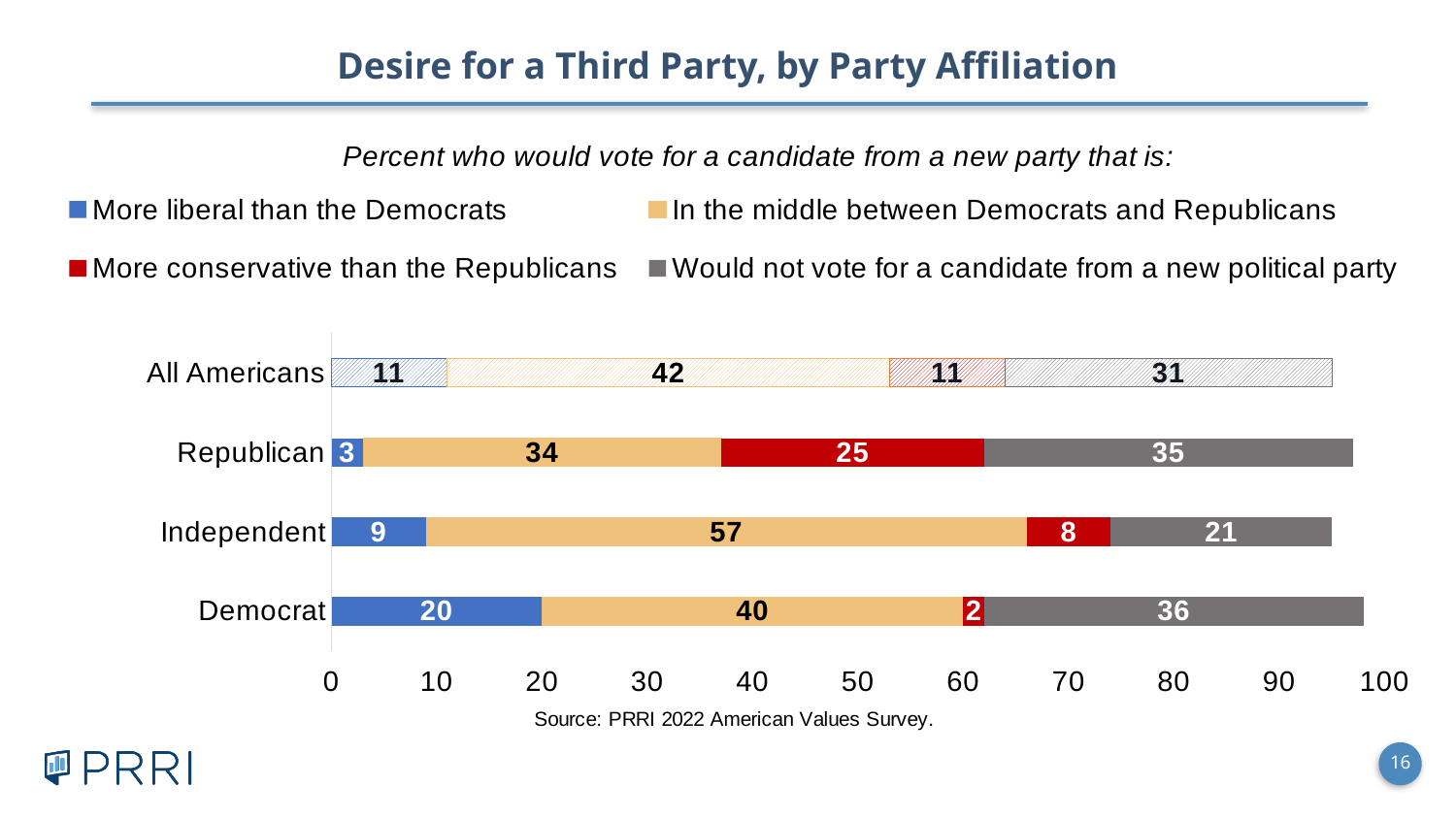
How many series does the legend list? 4 Which party affiliation group has the lowest value for 'More liberal than the Democrats'? Republican What is the difference between the Republican and Democrat values for 'More conservative than the Republicans'? 23 What percent of Democrats would vote for a candidate from a new party that is more liberal than the Democrats? 20 What kind of chart is shown on the slide? Stacked bar chart What percent of Independents would vote for a candidate from a new party that is in the middle between Democrats and Republicans? 57 Which party affiliation group has the highest value for 'In the middle between Democrats and Republicans'? Independent What percent of Republicans would vote for a candidate from a new party that is more conservative than the Republicans? 25 What percent of All Americans would not vote for a candidate from a new political party? 31 How many party affiliation groups are shown on the chart? 4 Which is larger: the Democrat value for 'Would not vote for a candidate from a new political party' or the Independent value for the same series? Democrat What is the total of the stacked bar for Republican? 97